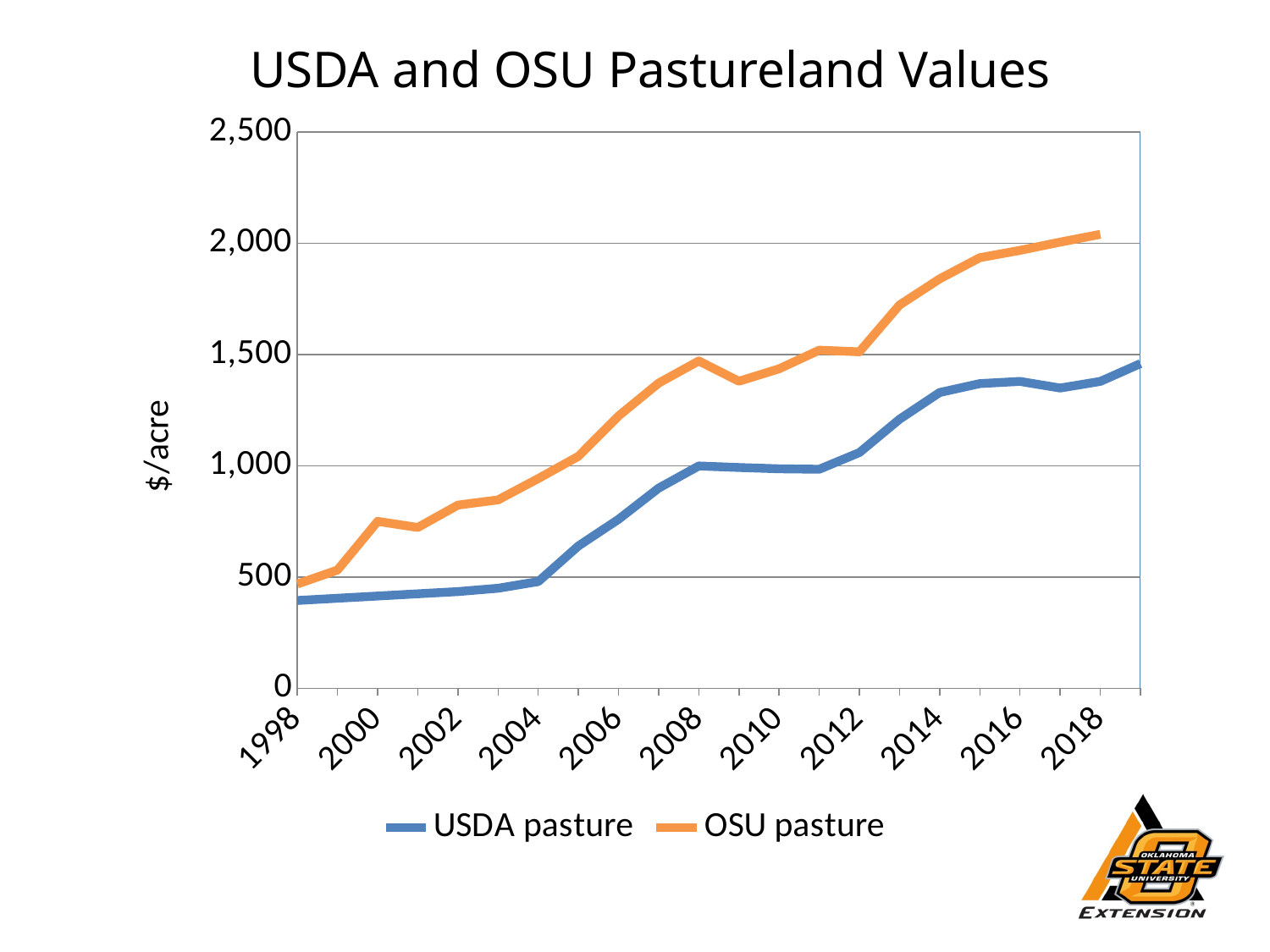
What is the title of the chart? USDA and OSU Pastureland Values Which series has the larger value in 2010, USDA pasture or OSU pasture? OSU pasture Is the value for USDA pasture in 2014 greater or less than 1,500? less Do the OSU pasture values generally rise or fall from 1998 to 2018? rise Is the value for USDA pasture in 1998 greater or less than 500? less What kind of chart is shown on the slide? line chart Is the value for OSU pasture in 2000 greater or less than 500? greater In which year is the OSU pasture value lowest? 1998 How many series does the legend list? 2 What is the label on the vertical axis? $/acre